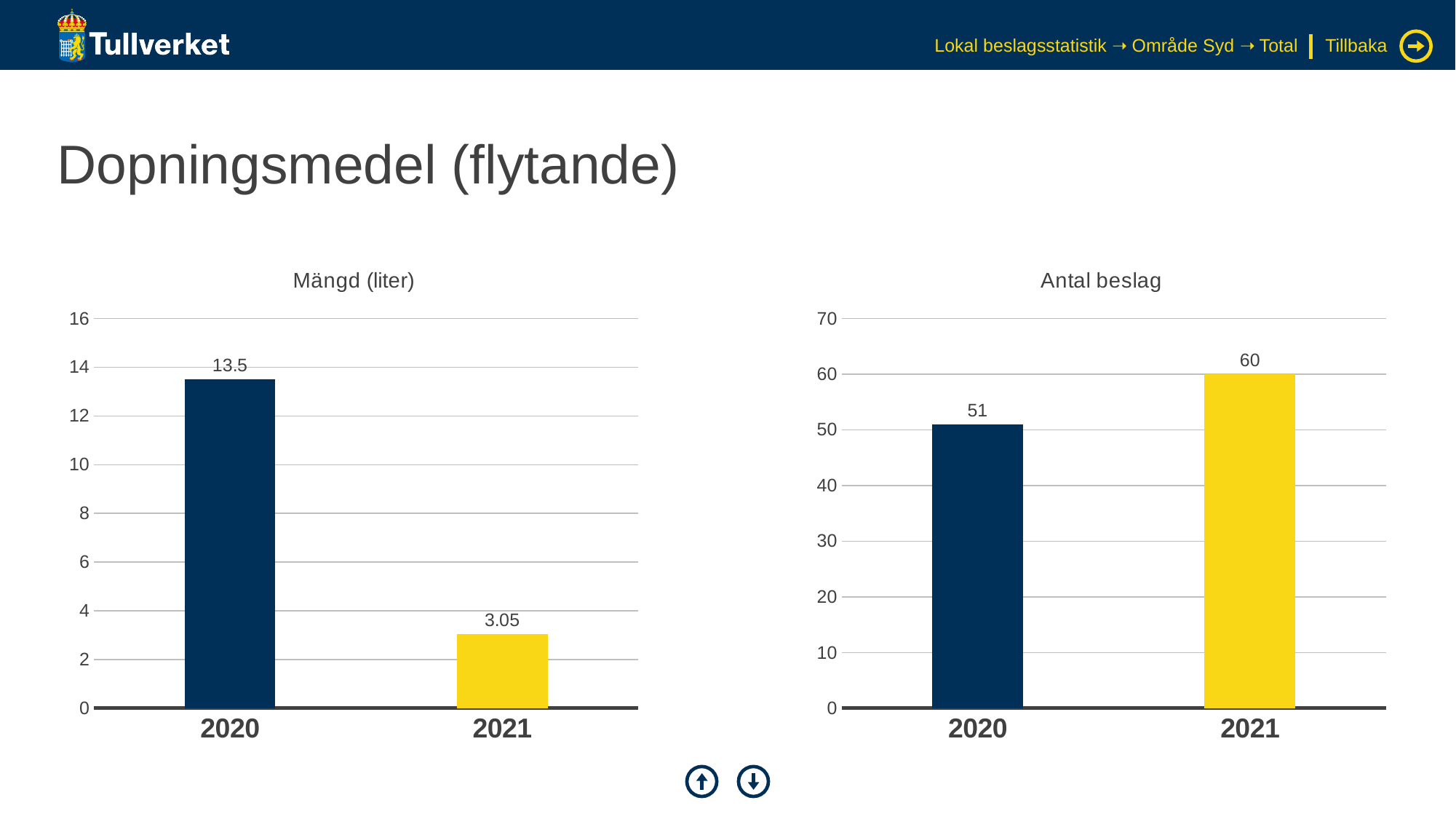
In the 'Mängd (liter)' chart, what is the difference between the values for 2020 and 2021? 10.45 In the 'Antal beslag' chart, is the value for 2021 larger or smaller than the value for 2020? larger What kind of chart is the 'Mängd (liter)' chart? bar chart In the 'Antal beslag' chart, what is the value for 2020? 51 In the 'Mängd (liter)' chart, which year has the highest value? 2020 In the 'Antal beslag' chart, what is the difference between the values for 2021 and 2020? 9 In the 'Mängd (liter)' chart, do the values rise or fall from 2020 to 2021? fall In the 'Antal beslag' chart, what is the value for 2021? 60 In the 'Antal beslag' chart, which year has the lowest value? 2020 How many categories are shown on the x axis of the 'Antal beslag' chart? 2 In the 'Mängd (liter)' chart, what is the value for 2021? 3.05 In the 'Mängd (liter)' chart, what is the value for 2020? 13.5